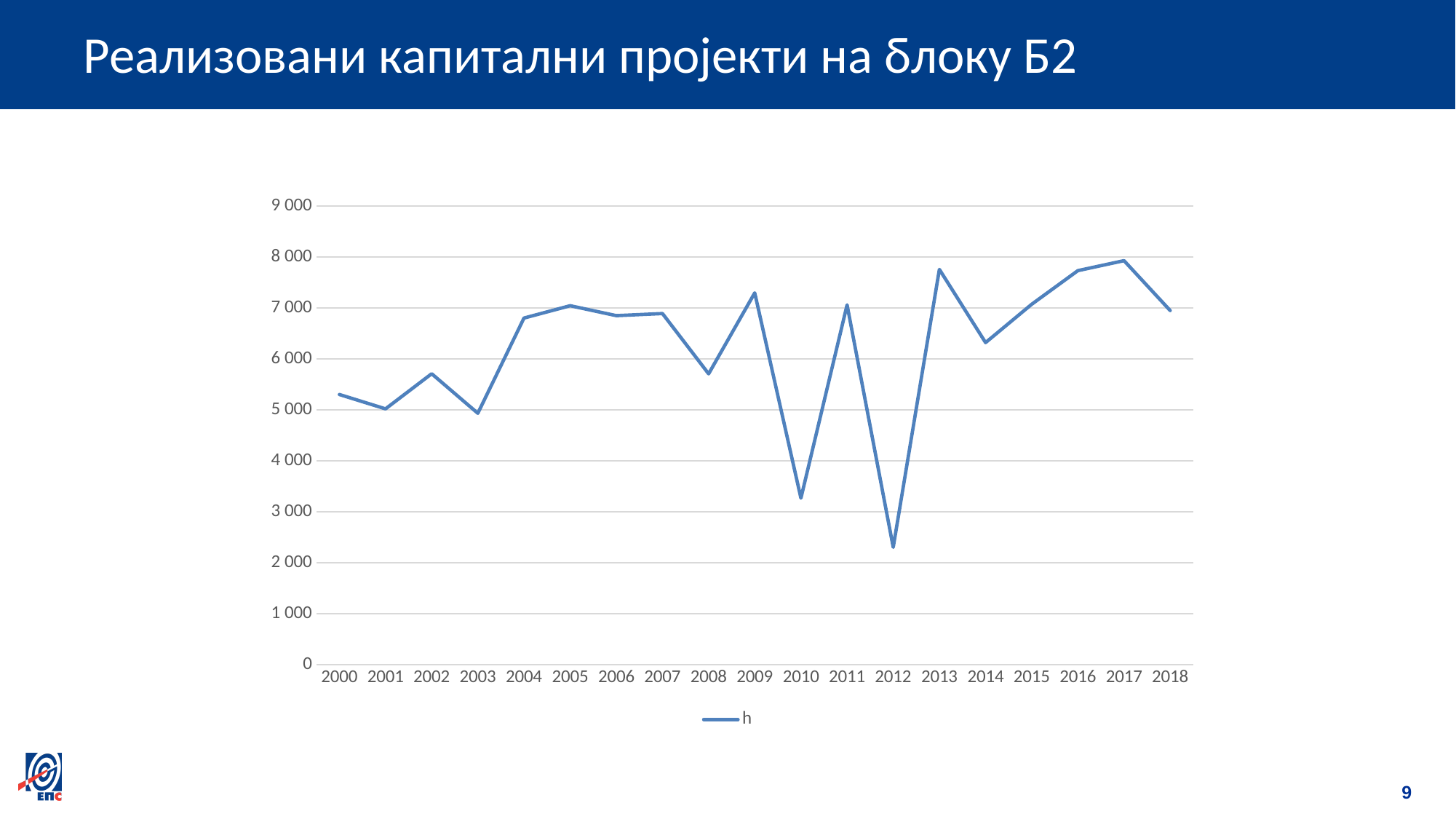
Is the value for 2004 greater or less than 6 000? greater How many years are plotted along the x axis of the chart? 19 How many series does the chart's legend list? 1 Which year has the larger value, 2008 or 2009? 2009 Is the value for 2017 greater or less than 8 000? less What kind of chart is shown on the slide? line chart Is the value for 2012 greater or less than 3 000? less Which year has the larger value, 2010 or 2011? 2011 Which year has the lowest value on the chart? 2012 What is the name of the series shown in the legend? h Does the value rise or fall from 2014 to 2017? rise